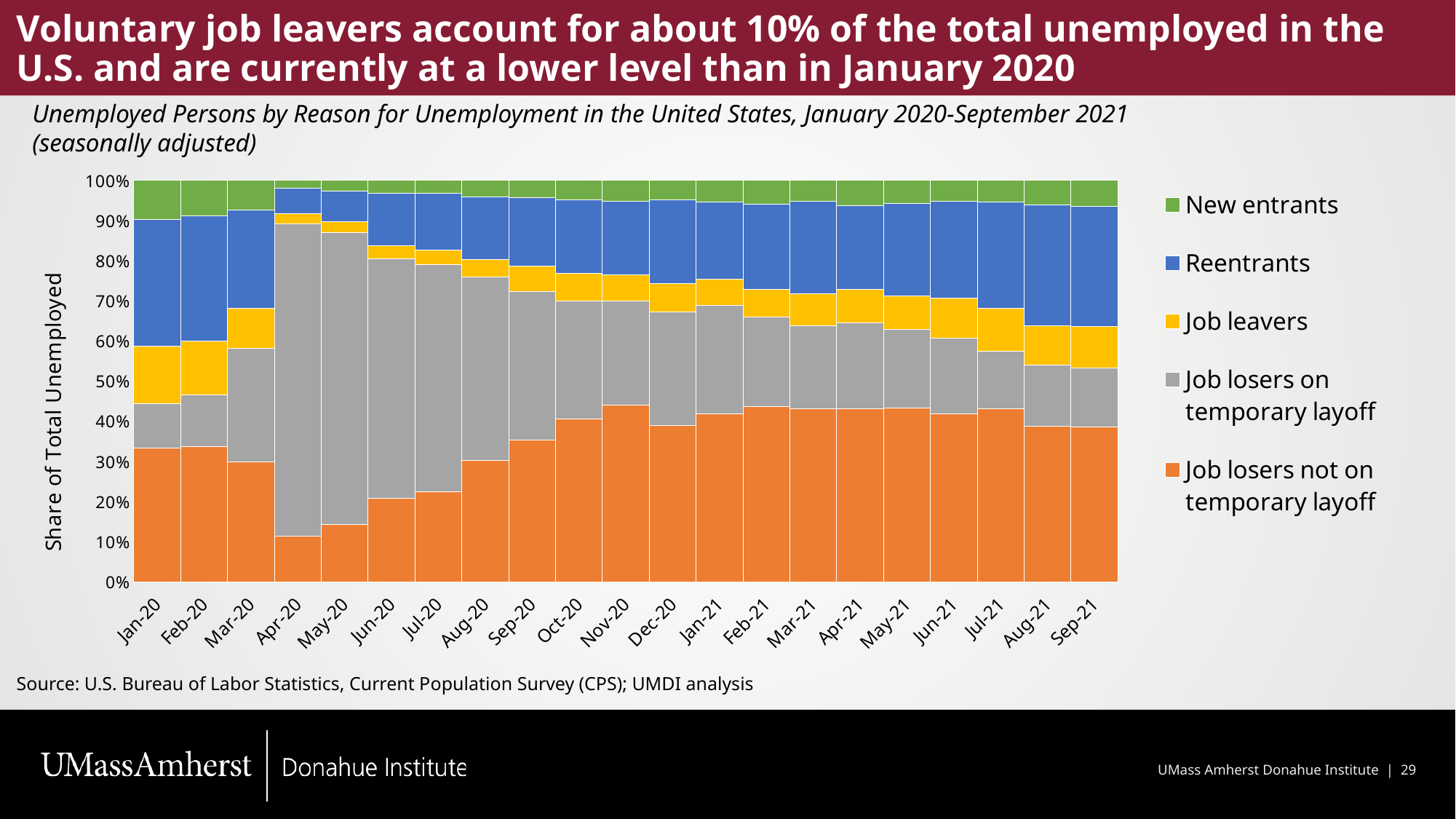
Which month has the highest share for Job losers on temporary layoff? Apr-20 What colour represents Job leavers in the chart? Yellow Does the share for Job losers on temporary layoff rise or fall from Apr-20 to Sep-21? Fall How many series does the chart's legend list? 5 Is the share for Job losers not on temporary layoff in Apr-20 greater or less than 20%? less Is the share for Job losers not on temporary layoff in Nov-20 greater or less than 40%? greater What is the title of the chart's y axis? Share of Total Unemployed What kind of chart is shown on the slide? Stacked bar chart Which month has the lowest share for Job losers not on temporary layoff? Apr-20 How many months are shown along the x axis of the chart? 21 Which is larger: the share for Job losers not on temporary layoff in Jan-20 or in Apr-20? Jan-20 Is the share for Job leavers in Apr-20 greater or less than 10%? less